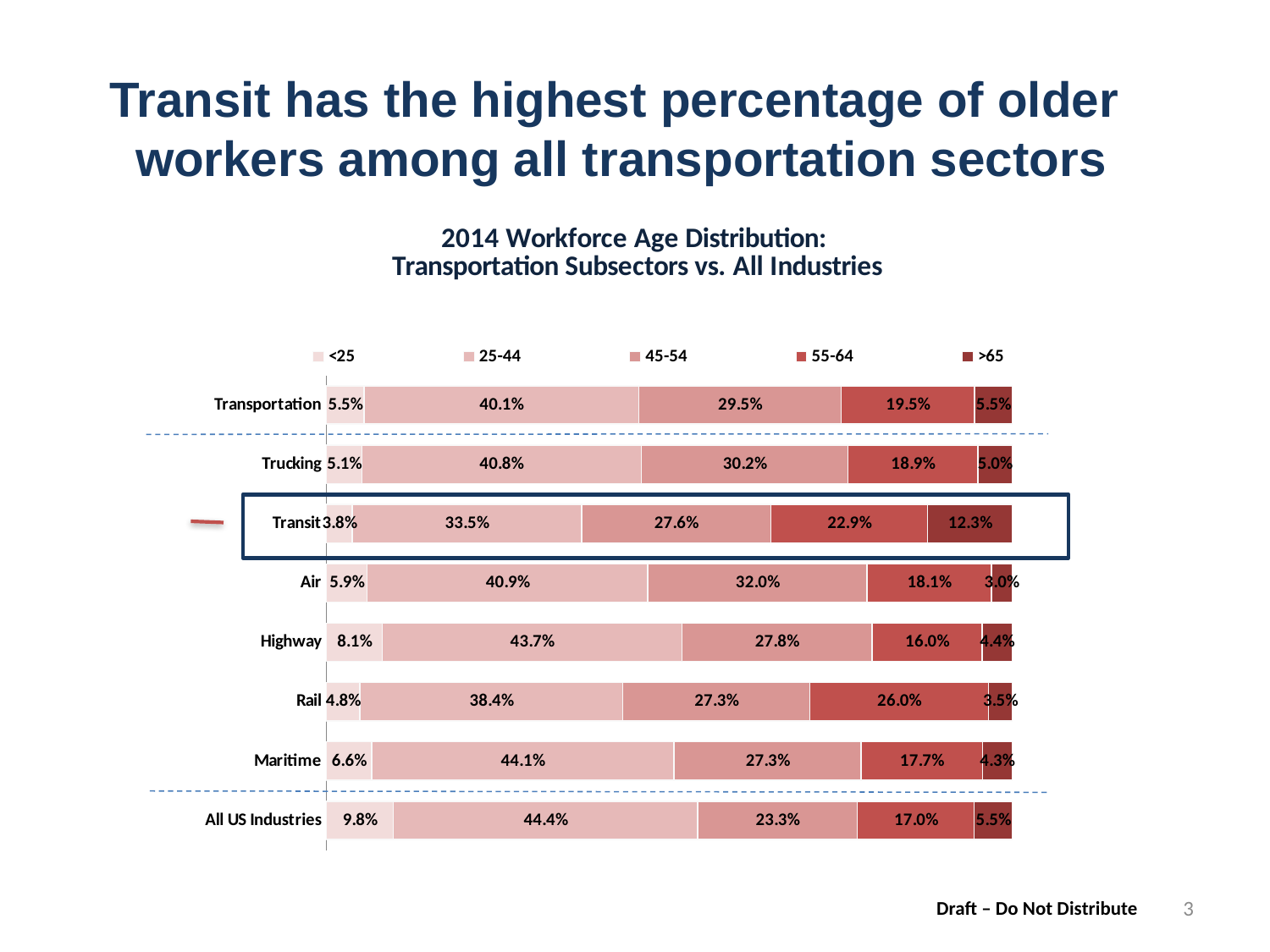
Which is larger: the 45-54 percentage for Air or for Highway? Air How many series does the legend list? 5 What percentage of the Maritime workforce is aged 25-44? 44.1% Which category has the lowest percentage of workers aged >65? Air Which category has the highest percentage of workers aged <25? All US Industries What kind of chart is shown on the slide? Stacked bar chart What percentage of the Transit workforce is aged >65? 12.3% What is the difference between the >65 percentage for Transit and for Trucking? 7.3% What percentage of the Rail workforce is aged 55-64? 26.0% What percentage of the All US Industries workforce is aged <25? 9.8% Which category has the highest percentage of workers aged >65? Transit How many categories are shown on the chart? 8